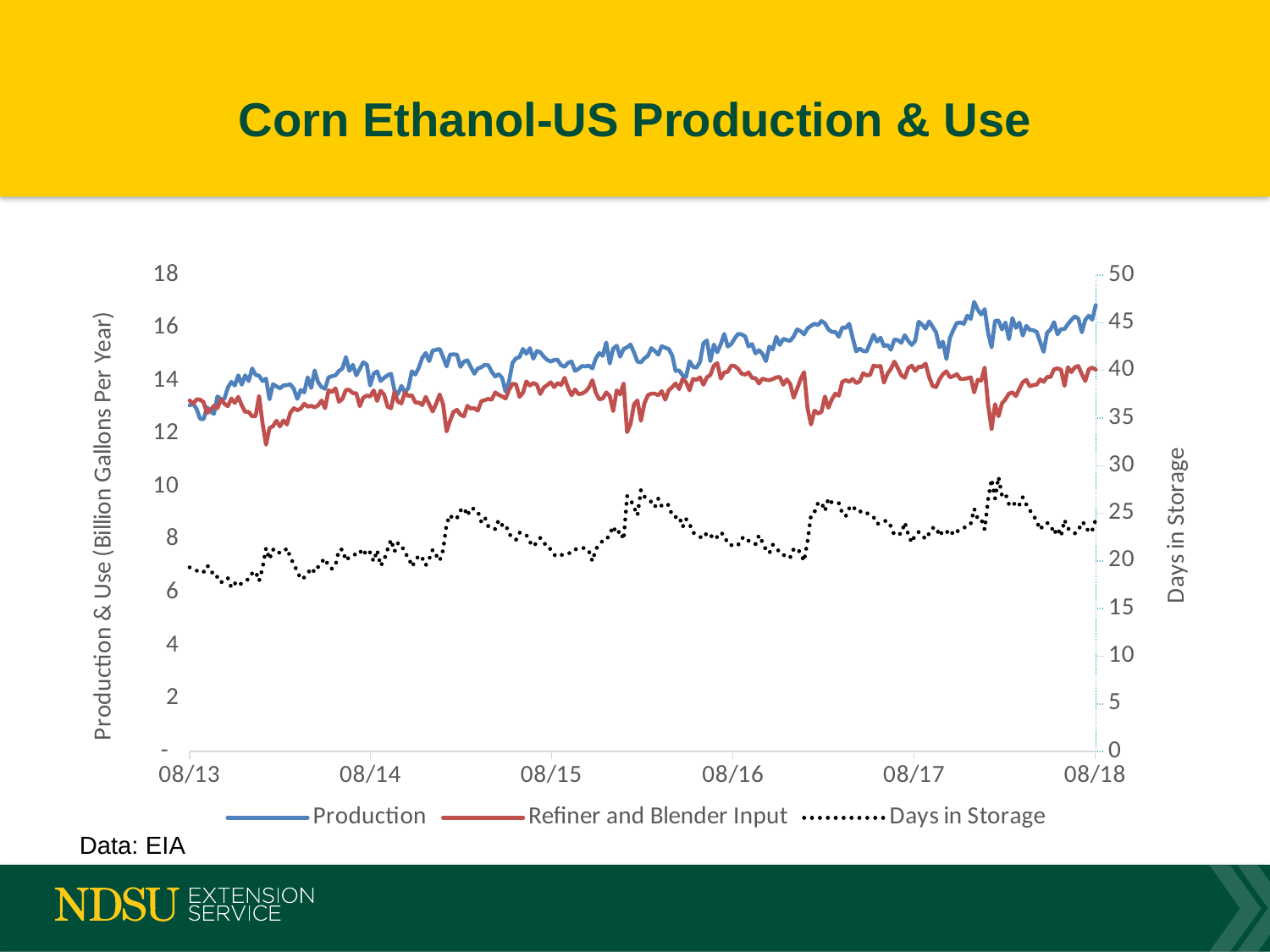
How many series does the legend list? 3 Is the Refiner and Blender Input value at 08/18 greater or less than 12 billion gallons per year? greater Is Production larger at 08/13 or at 08/18? 08/18 Does the Production series generally rise or fall from 08/13 to 08/18? Rise At 08/18, which is larger: Production or Refiner and Blender Input? Production Is the Days in Storage value at 08/13 greater or less than 25? less What is the title of the chart? Corn Ethanol-US Production & Use What is the label of the right-hand vertical axis? Days in Storage How many date labels are shown on the x axis? 6 What kind of chart is shown on the slide? Line chart Is the Production value at 08/13 greater or less than 14 billion gallons per year? less